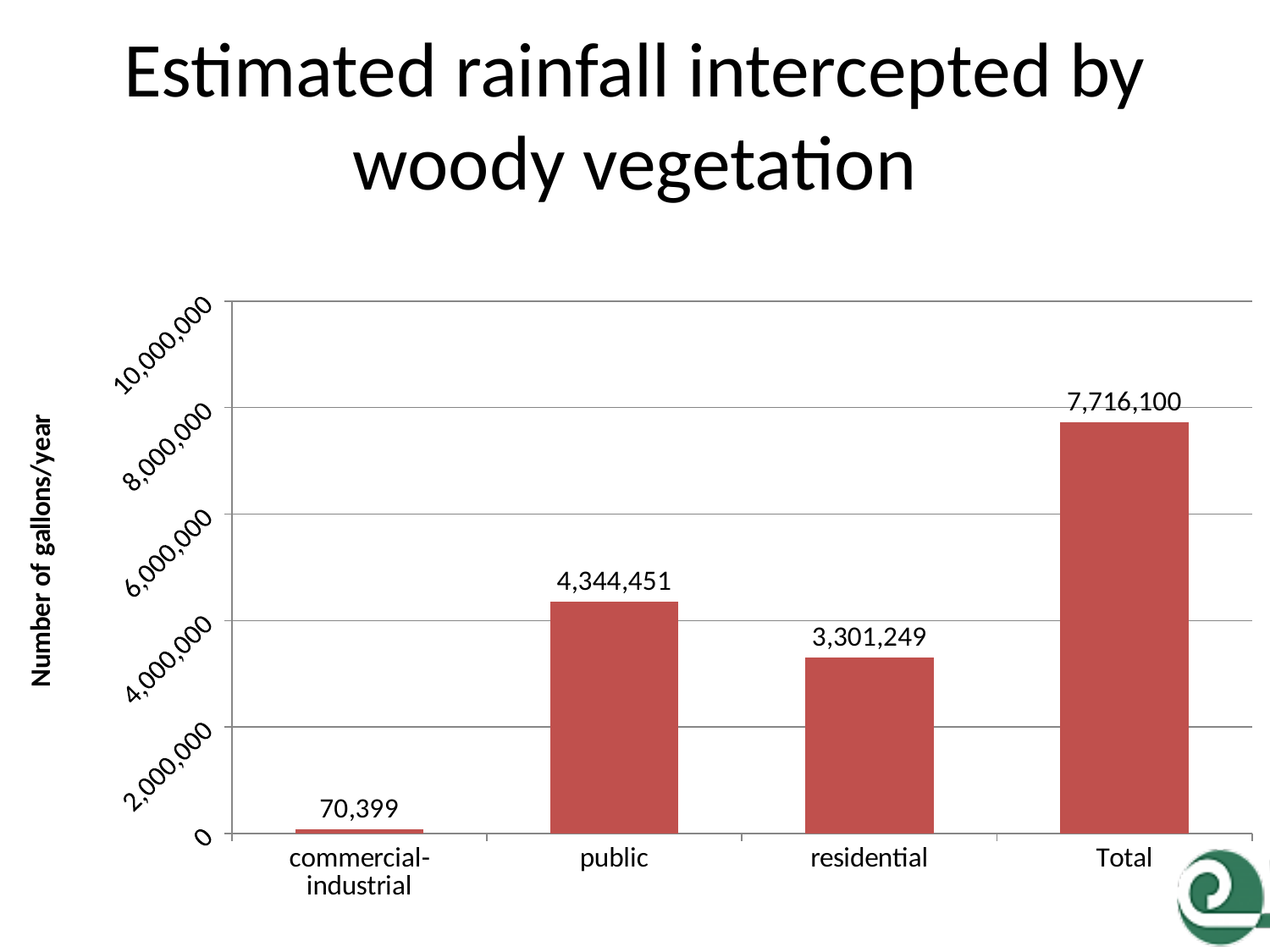
What value is shown for the residential category? 3,301,249 Excluding the Total bar, which category has the highest value? public What is the estimated rainfall intercepted for the public category? 4,344,451 What is the label of the y axis? Number of gallons/year What kind of chart is shown on the slide? bar chart Which is larger, the value for public or the value for residential? public What is the value of the Total bar? 7,716,100 What is the difference between the public and residential values? 1,043,202 Is the value for residential greater or less than 4,000,000? less What value is shown for the commercial-industrial category? 70,399 How many categories are shown on the x axis? 4 Which category has the lowest value? commercial-industrial